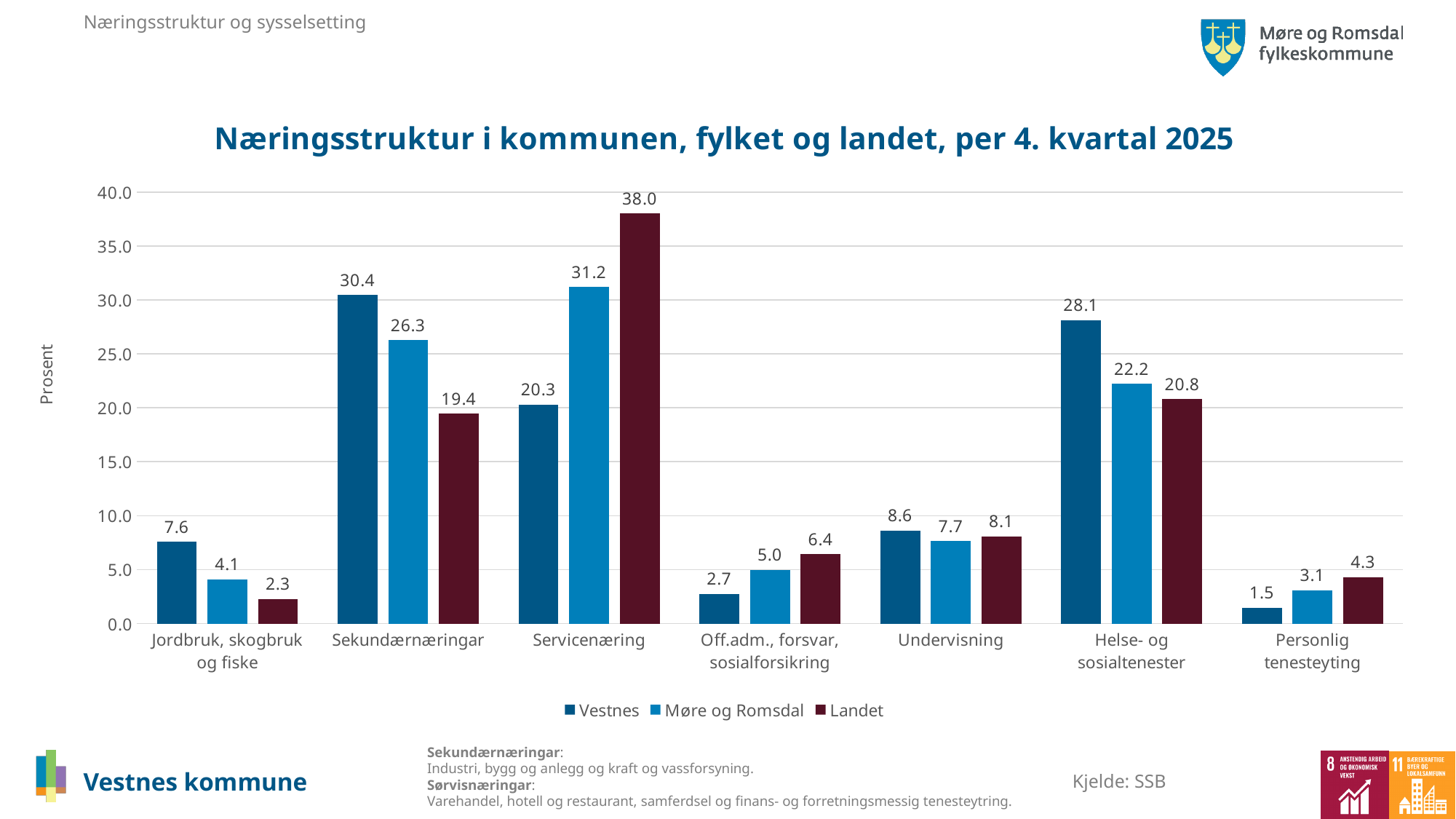
Which category has the highest value for Vestnes? Sekundærnæringar Is the value for Møre og Romsdal in the Servicenæring category greater or less than 30.0? greater What kind of chart is shown on the slide? Bar chart What is the value for Vestnes in the Sekundærnæringar category? 30.4 Which category has the lowest value for Landet? Jordbruk, skogbruk og fiske What is the difference between the Landet and Vestnes values in the Servicenæring category? 17.7 How many series does the legend list? 3 What is the label of the y axis? Prosent How many categories are shown on the x axis? 7 What is the value for Møre og Romsdal in the Helse- og sosialtenester category? 22.2 In the Undervisning category, which is larger: the value for Vestnes or the value for Møre og Romsdal? Vestnes What is the value for Landet in the Servicenæring category? 38.0